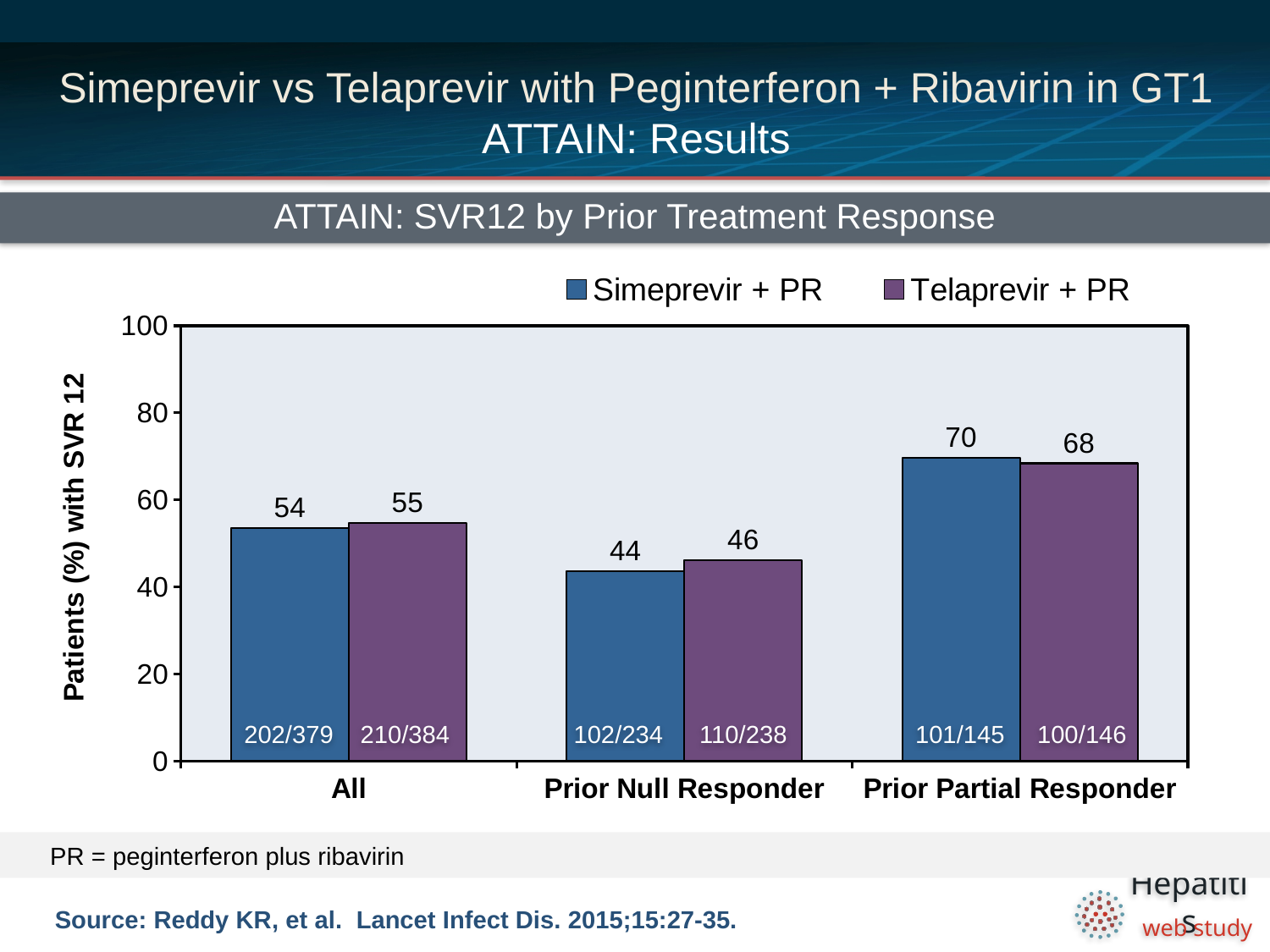
Which is larger: the Simeprevir + PR rate for Prior Partial Responders or the Simeprevir + PR rate for Prior Null Responders? Prior Partial Responder How many series does the legend list? 2 What is the difference between the Simeprevir + PR and Telaprevir + PR SVR12 rates among Prior Partial Responders? 2 What fraction is printed on the Simeprevir + PR bar for Prior Null Responders? 102/234 What is the SVR12 rate for Telaprevir + PR among Prior Null Responders? 46 What kind of chart is shown on the slide? bar chart What is the SVR12 rate for Simeprevir + PR among Prior Partial Responders? 70 What is the SVR12 rate for Simeprevir + PR in the All group? 54 Which prior treatment response category has the highest SVR12 rate for Telaprevir + PR? Prior Partial Responder Which category has the lowest SVR12 rate for Simeprevir + PR? Prior Null Responder How many prior treatment response categories are shown on the x axis? 3 Is the Telaprevir + PR value for Prior Null Responders greater or less than 60? less